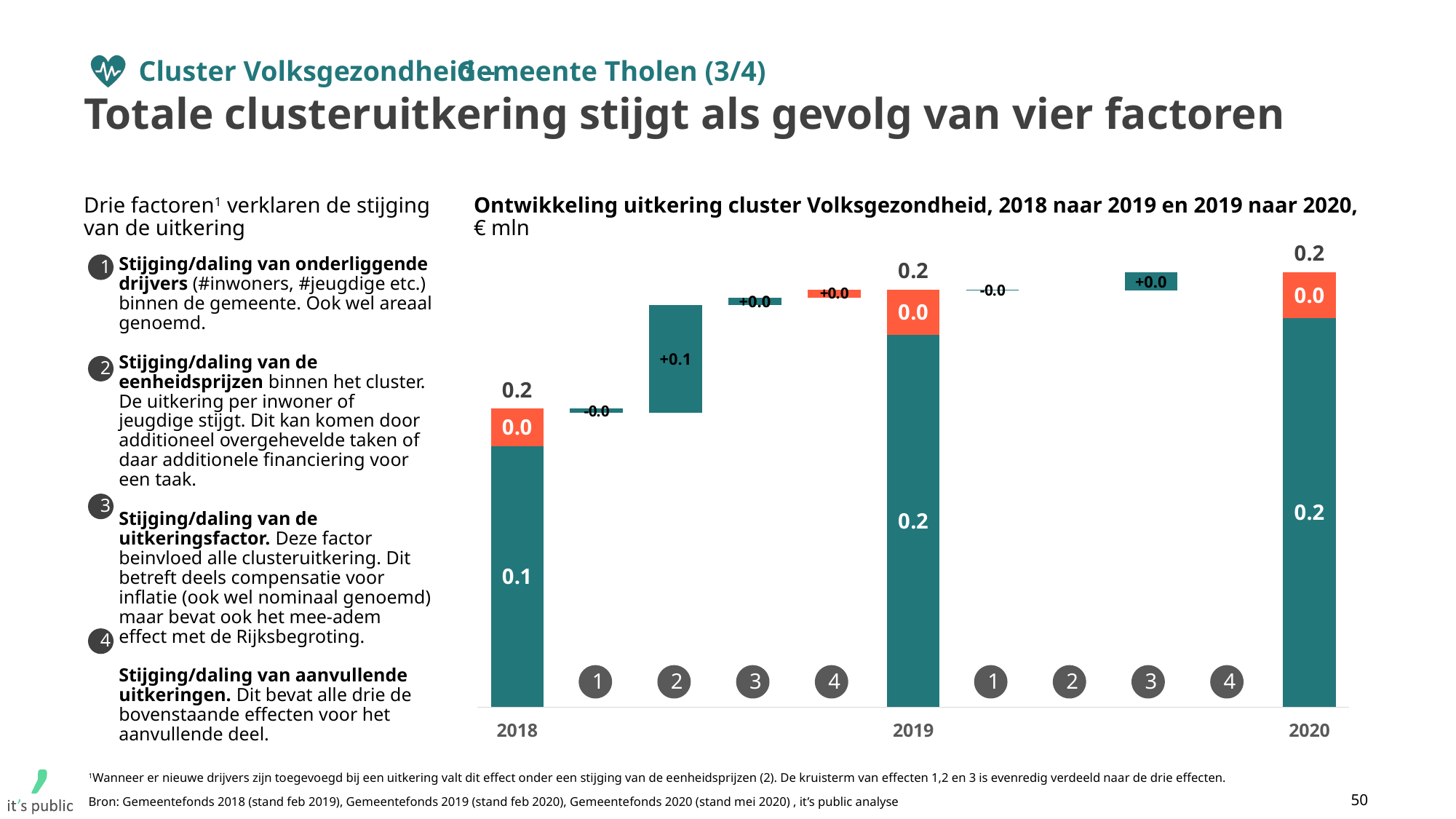
What is the value of the teal (lower) segment of the 2018 bar? 0.1 What is the total value of the bar for 2018? 0.2 What is the value of the orange (upper) segment of the 2020 bar? 0.0 What is the value of the teal (lower) segment of the 2019 bar? 0.2 Which is larger: the teal segment of the 2018 bar or the teal segment of the 2019 bar? 2019 What is the value of step 2 between 2018 and 2019? +0.1 In what unit are the values in the chart expressed? € mln How many year totals (full bars) are shown on the x axis? 3 What kind of chart is shown on the slide? Bar chart Which of the four steps between 2018 and 2019 has the largest value? 2 What is the total value of the bar for 2020? 0.2 What is the difference between the teal segment of the 2019 bar and the teal segment of the 2018 bar? 0.1